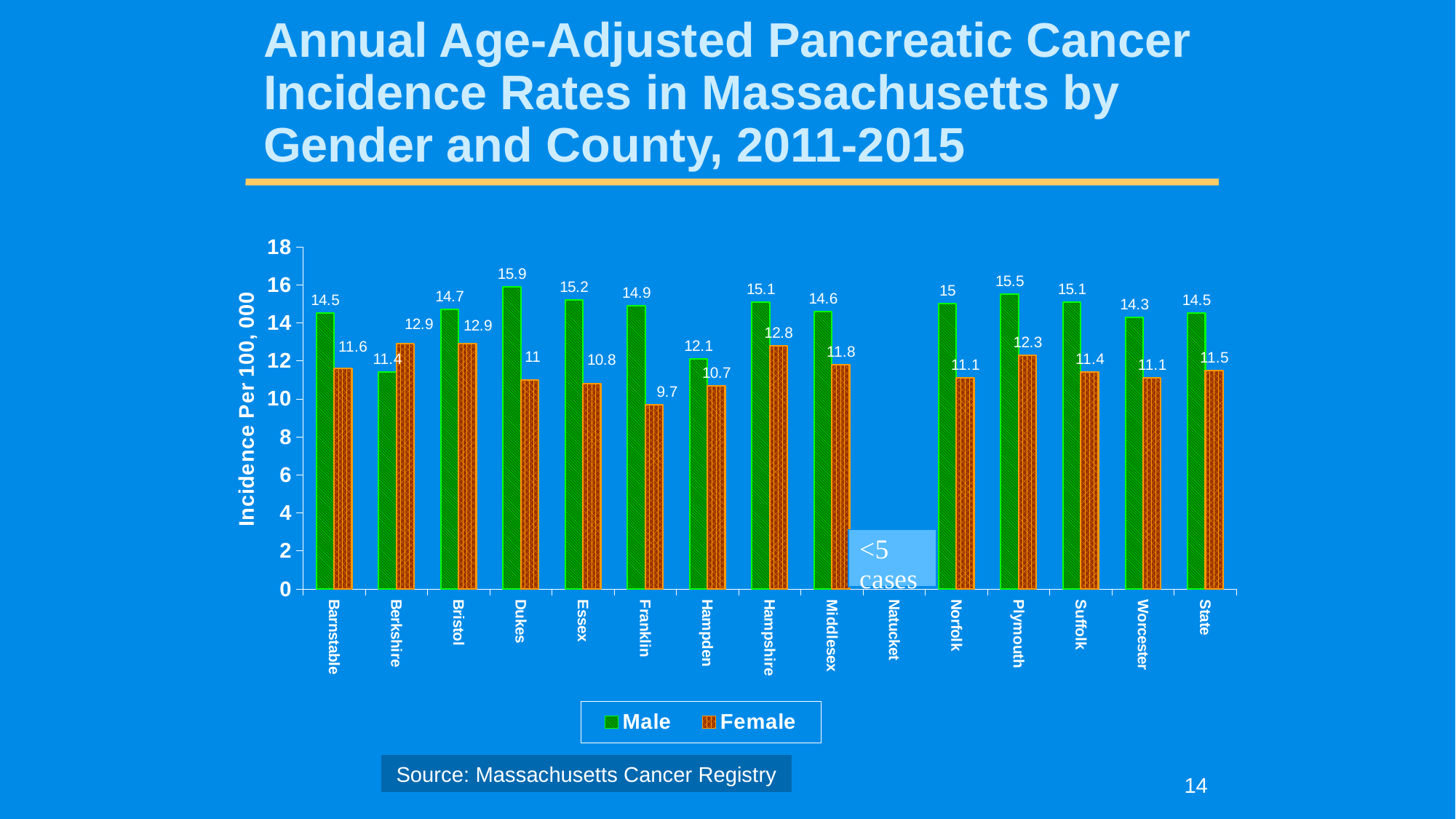
Which is larger in Berkshire county, the male rate or the female rate? Female What is shown for Nantucket county instead of bars? <5 cases What kind of chart is shown on the slide? Bar chart What is the male pancreatic cancer incidence rate for Dukes county? 15.9 Which county has the highest male incidence rate? Dukes What is the male incidence rate for the State overall? 14.5 What is the difference between the male and female incidence rates in Dukes county? 4.9 What is the female incidence rate for Franklin county? 9.7 Which county has the lowest female incidence rate? Franklin What is the female incidence rate for Plymouth county? 12.3 How many series does the legend list? 2 Which county has the lowest male incidence rate? Berkshire